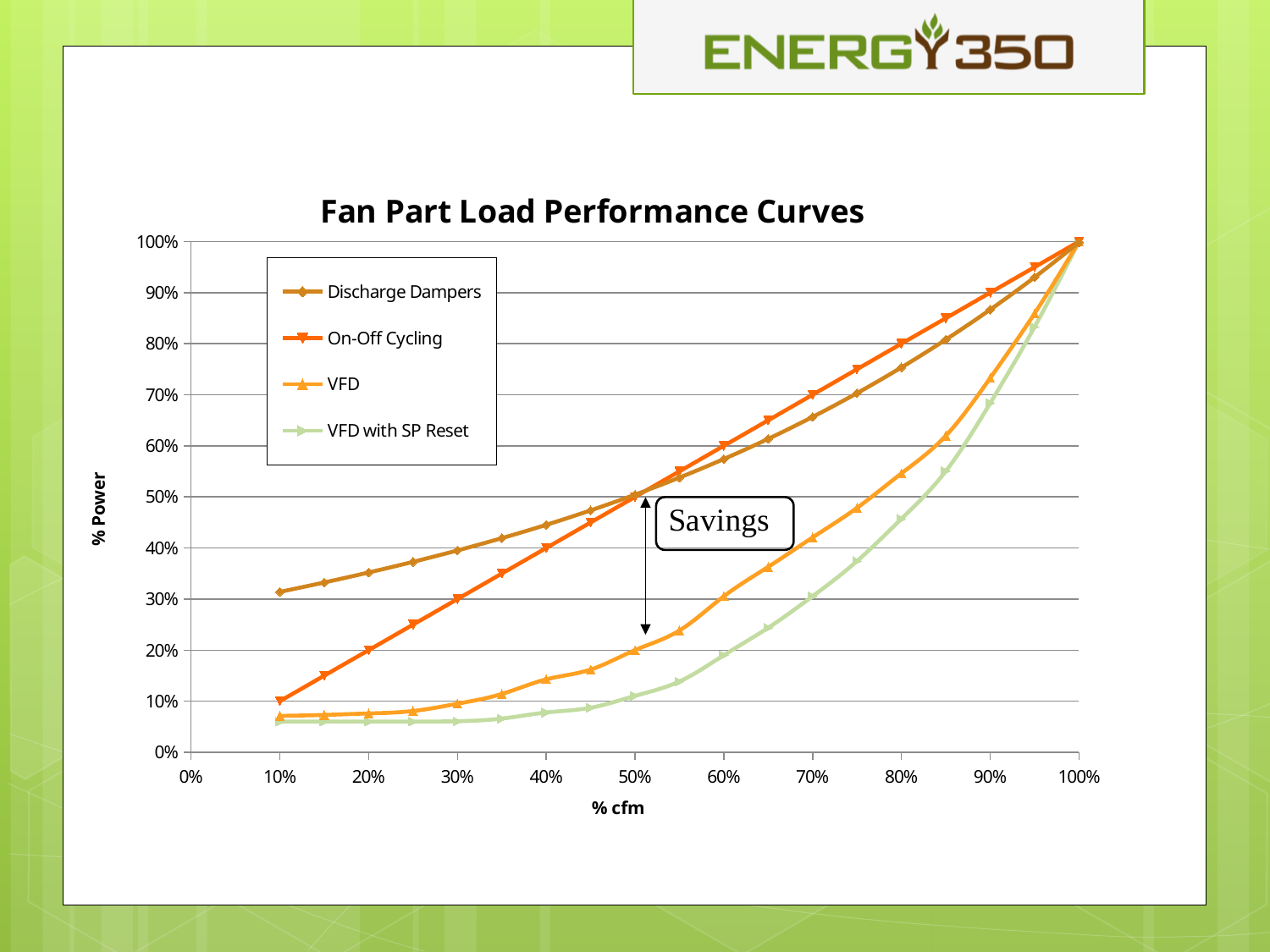
What kind of chart is shown on the slide? line chart At 10% cfm, which series has the highest % Power? Discharge Dampers How many series does the legend list? 4 At 50% cfm, which series has the lowest % Power? VFD with SP Reset Is the value for Discharge Dampers at 10% cfm greater or less than 20%? greater What is the title of the chart? Fan Part Load Performance Curves What is the label on the vertical axis? % Power What is the % Power value for On-Off Cycling at 50% cfm? 50% Is the value for VFD with SP Reset at 50% cfm greater or less than 20%? less Is the value for VFD at 60% cfm greater or less than 40%? less At 30% cfm, which series has the higher % Power: Discharge Dampers or On-Off Cycling? Discharge Dampers What is the % Power value for On-Off Cycling at 100% cfm? 100%